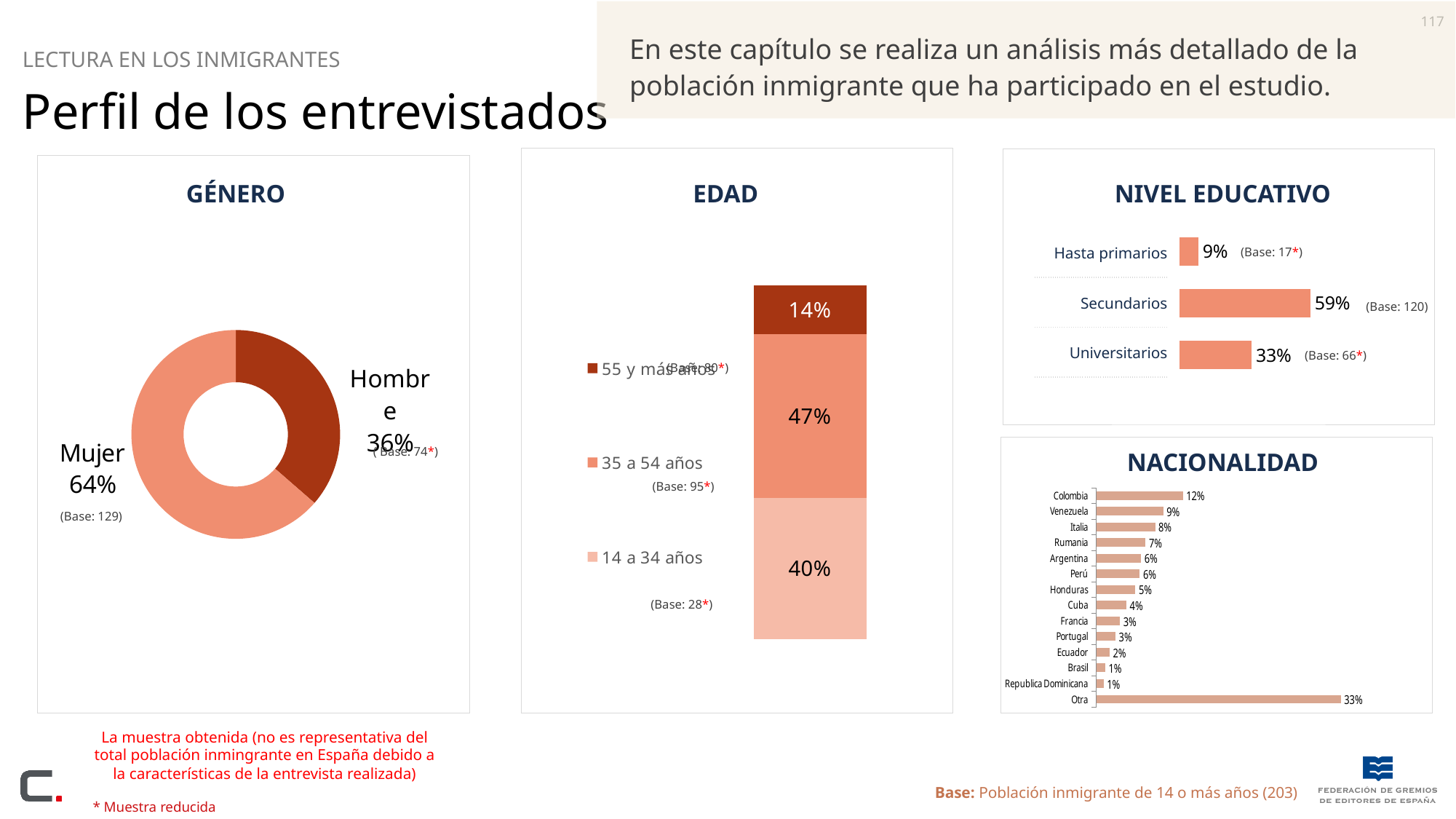
In the NACIONALIDAD chart, what is the value for Colombia? 12% In the NACIONALIDAD chart, which is larger, Venezuela or Italia? Venezuela In the EDAD chart, which age group has the smallest share? 55 y más años In the EDAD chart, what is the difference between the 35 a 54 años and 14 a 34 años segments? 7% In the GÉNERO chart, what percentage of respondents are Mujer? 64% How many categories are shown in the NACIONALIDAD chart? 14 In the NIVEL EDUCATIVO chart, what is the value for Secundarios? 59% In the NIVEL EDUCATIVO chart, which category has the lowest value? Hasta primarios In the NIVEL EDUCATIVO chart, what is the difference between Secundarios and Universitarios? 26% In the EDAD chart, what is the value for 35 a 54 años? 47% How many series does the legend of the EDAD chart list? 3 What type of chart is the GÉNERO chart? Donut (pie) chart